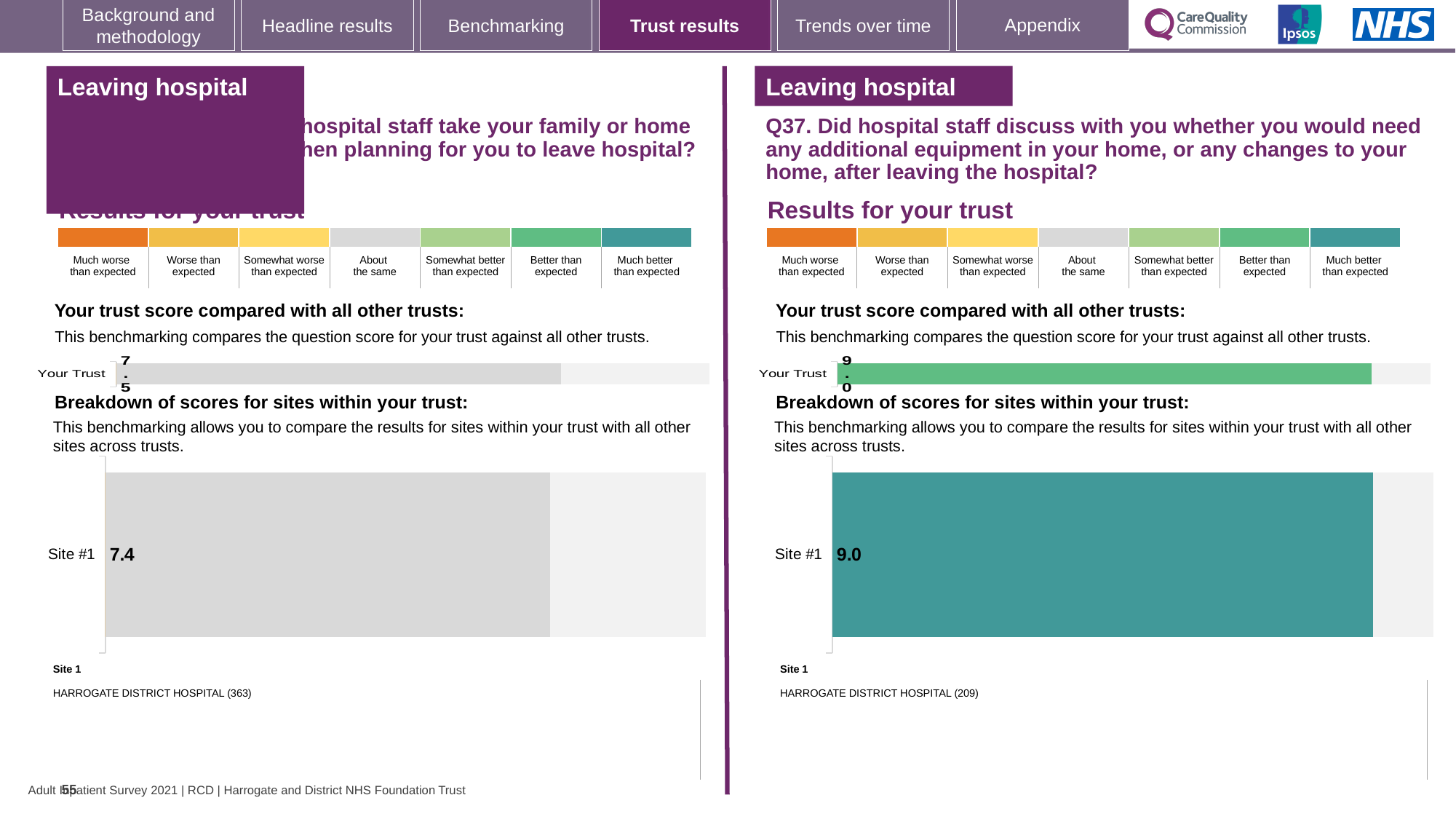
How many sites are shown on the left-hand 'Breakdown of scores for sites within your trust' chart? 1 On the right-hand (Q37) 'Your trust score compared with all other trusts' chart, what colour is the Your Trust bar? green On the right-hand (Q37) 'Breakdown of scores for sites within your trust' chart, what is the score for Site #1? 9.0 Which is larger, the Site #1 score on the left-hand site breakdown chart or the Site #1 score on the right-hand (Q37) site breakdown chart? the right-hand chart How many sites are shown on the right-hand (Q37) 'Breakdown of scores for sites within your trust' chart? 1 On the left-hand side, what is the difference between the Your Trust score (7.5) and the Site #1 score (7.4)? 0.1 What kind of chart is the right-hand (Q37) 'Breakdown of scores for sites within your trust' chart? bar chart On the left-hand 'Your trust score compared with all other trusts' chart, what is the score for Your Trust? 7.5 On the right-hand (Q37) 'Your trust score compared with all other trusts' chart, what is the score for Your Trust? 9.0 On the right-hand (Q37) site breakdown chart, which hospital is listed as Site 1? Harrogate District Hospital (209) What is the difference between the Your Trust score on the right-hand (Q37) trust score chart and the Your Trust score on the left-hand trust score chart? 1.5 On the left-hand 'Breakdown of scores for sites within your trust' chart, what is the score for Site #1? 7.4